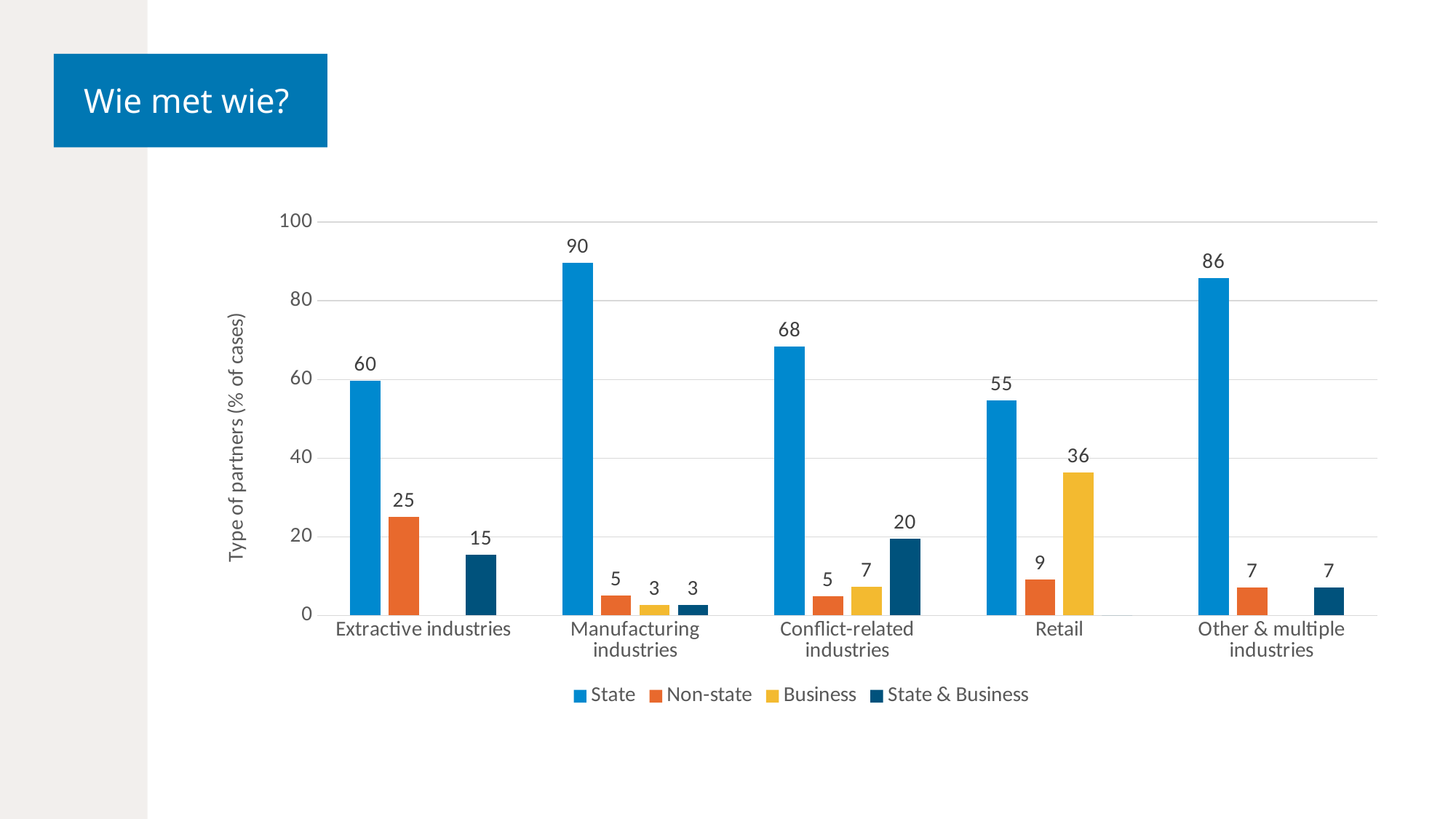
Which category has the highest State value? Manufacturing industries What is the label of the vertical axis? Type of partners (% of cases) Which is larger: the Non-state value for Retail or the Non-state value for Manufacturing industries? Retail What is the Non-state value for Extractive industries? 25 How many categories are shown on the x axis? 5 Which category has the lowest State value? Retail What is the State & Business value for Conflict-related industries? 20 What is the State value for Manufacturing industries? 90 What is the Business value for Retail? 36 What is the difference between the State values for Other & multiple industries and Extractive industries? 26 What kind of chart is shown on the slide? Bar chart How many series does the legend list? 4